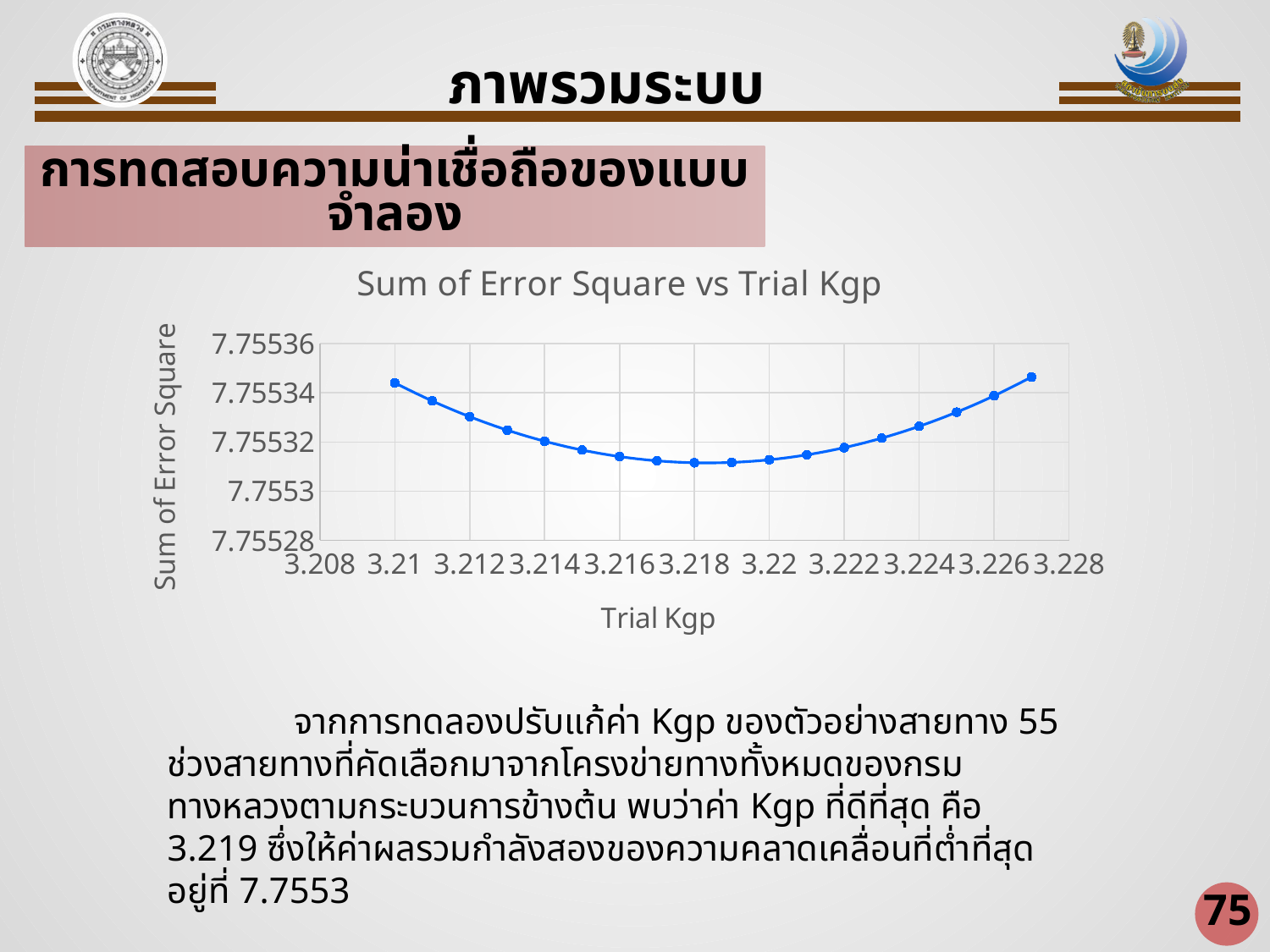
Is the Sum of Error Square at Trial Kgp 3.222 greater or less than 7.75534? less Which has a larger Sum of Error Square, Trial Kgp 3.227 or Trial Kgp 3.22? 3.227 Which has a larger Sum of Error Square, Trial Kgp 3.21 or Trial Kgp 3.218? 3.21 How many data points are plotted on the chart? 18 What kind of chart is shown on the slide? line chart Is the Sum of Error Square at Trial Kgp 3.218 greater or less than 7.75532? less Which has a smaller Sum of Error Square, Trial Kgp 3.214 or Trial Kgp 3.217? 3.217 How does the Sum of Error Square change as Trial Kgp increases from 3.21 to 3.227? It falls and then rises What is the title of the chart? Sum of Error Square vs Trial Kgp Is the Sum of Error Square at Trial Kgp 3.227 greater or less than 7.75534? greater What is the label of the x axis of the chart? Trial Kgp